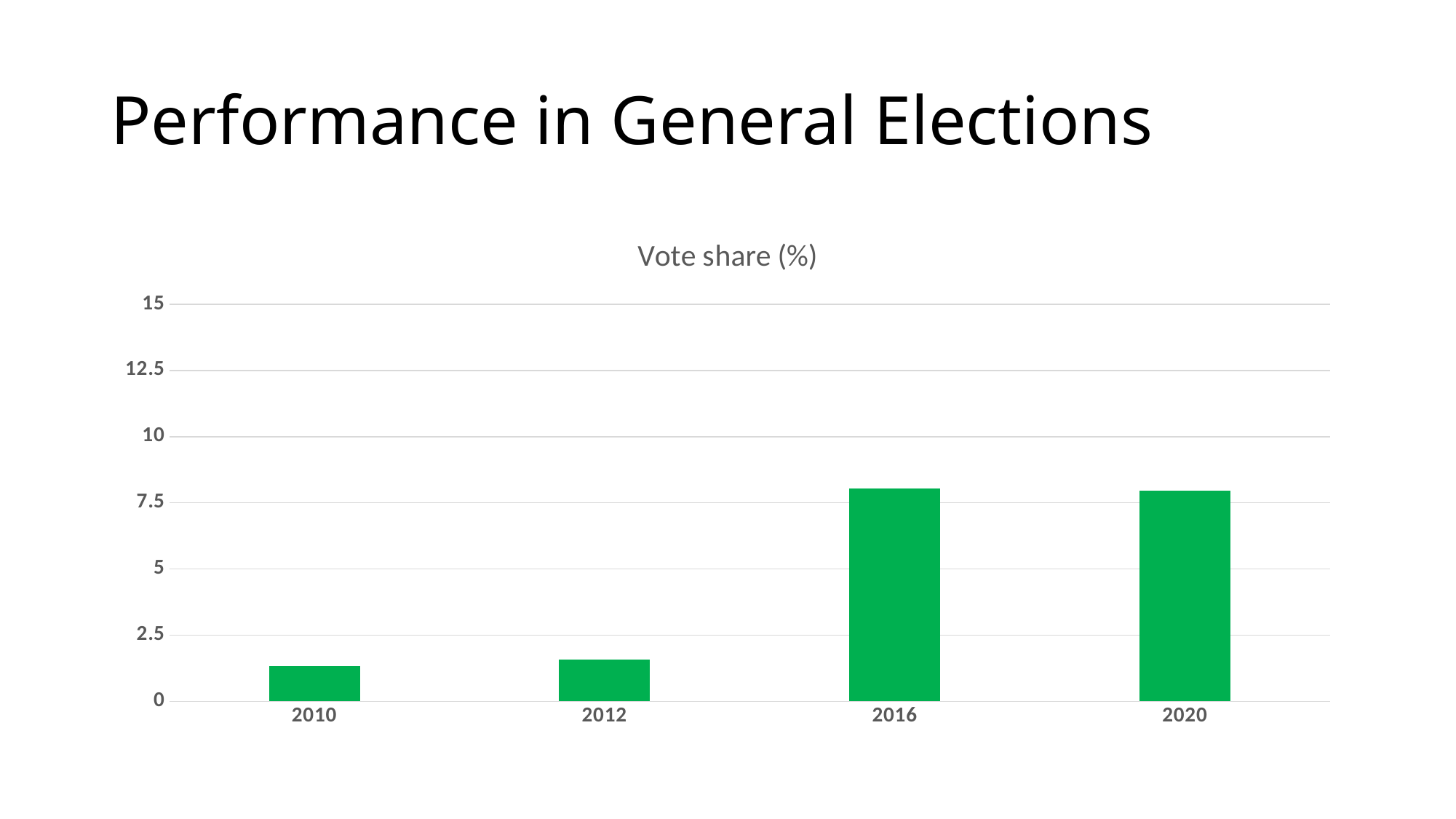
How many years are shown on the x axis of the chart? 4 What colour are the bars in the chart? green Which year has the larger vote share, 2012 or 2020? 2020 Is the vote share for 2016 greater or less than 7.5? greater Is the vote share for 2020 greater or less than 5? greater Does the vote share generally rise or fall from 2010 to 2020? rise Is the vote share for 2010 greater or less than 2.5? less Which year has the larger vote share, 2010 or 2016? 2016 What is the title of the chart? Vote share (%) What kind of chart is shown on the slide? bar chart